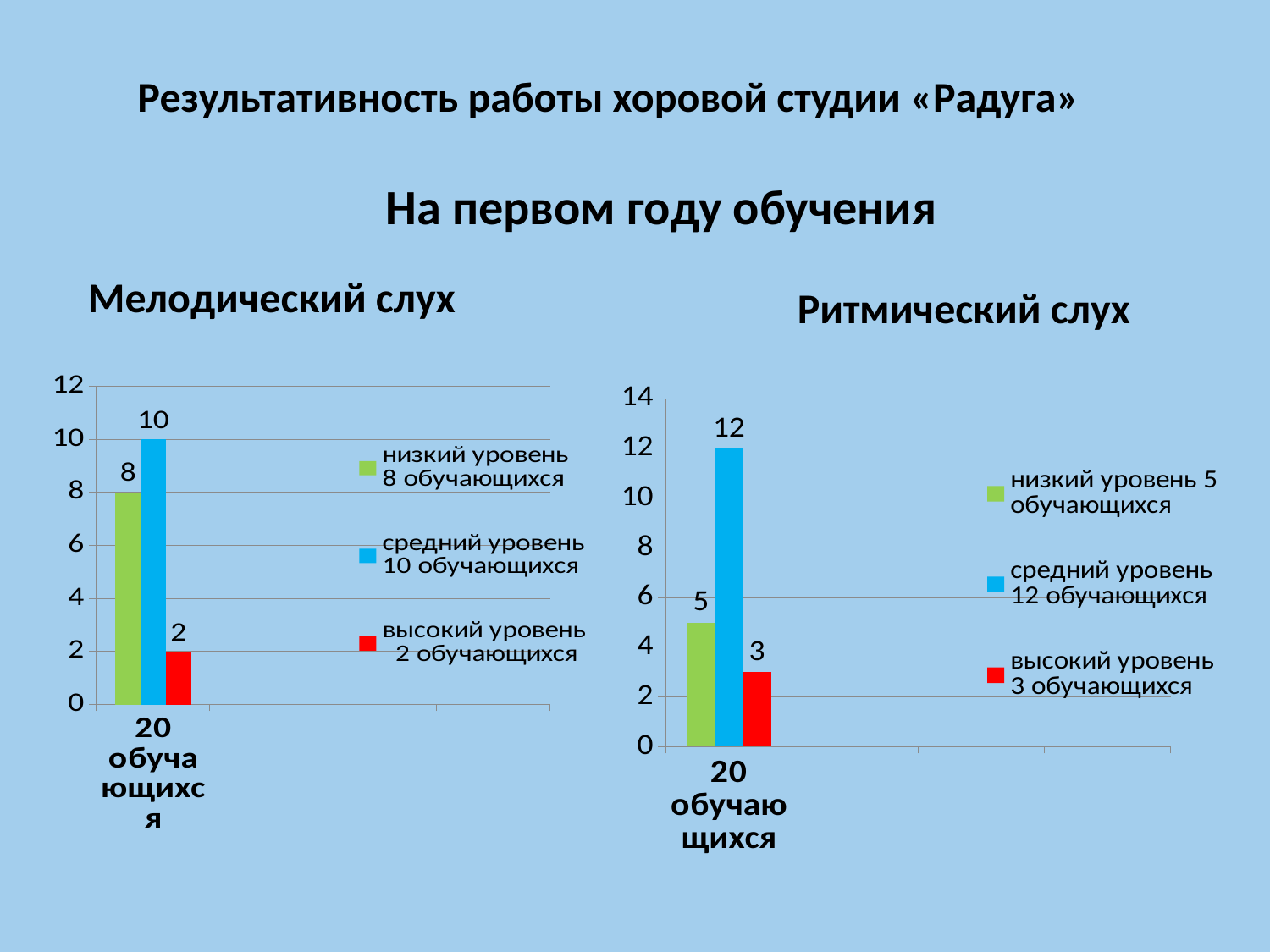
In the "Ритмический слух" chart, which series has the highest value? средний уровень 12 обучающихся In the "Ритмический слух" chart, which is larger: the value for "низкий уровень" or "высокий уровень"? низкий уровень In the "Мелодический слух" chart, what colour is the bar for "средний уровень 10 обучающихся"? blue In the "Мелодический слух" chart, what is the value for "средний уровень 10 обучающихся"? 10 How many series does the legend of the "Мелодический слух" chart list? 3 In the "Ритмический слух" chart, what is the difference between the values for "средний уровень" and "высокий уровень"? 9 In the "Мелодический слух" chart, which series has the lowest value? высокий уровень 2 обучающихся In the "Ритмический слух" chart, what is the total of the three plotted values? 20 What kind of chart is the "Ритмический слух" chart? bar chart In the "Мелодический слух" chart, what is the value for "высокий уровень 2 обучающихся"? 2 In the "Ритмический слух" chart, what is the value for "низкий уровень 5 обучающихся"? 5 In the "Мелодический слух" chart, what is the difference between the values for "средний уровень" and "низкий уровень"? 2